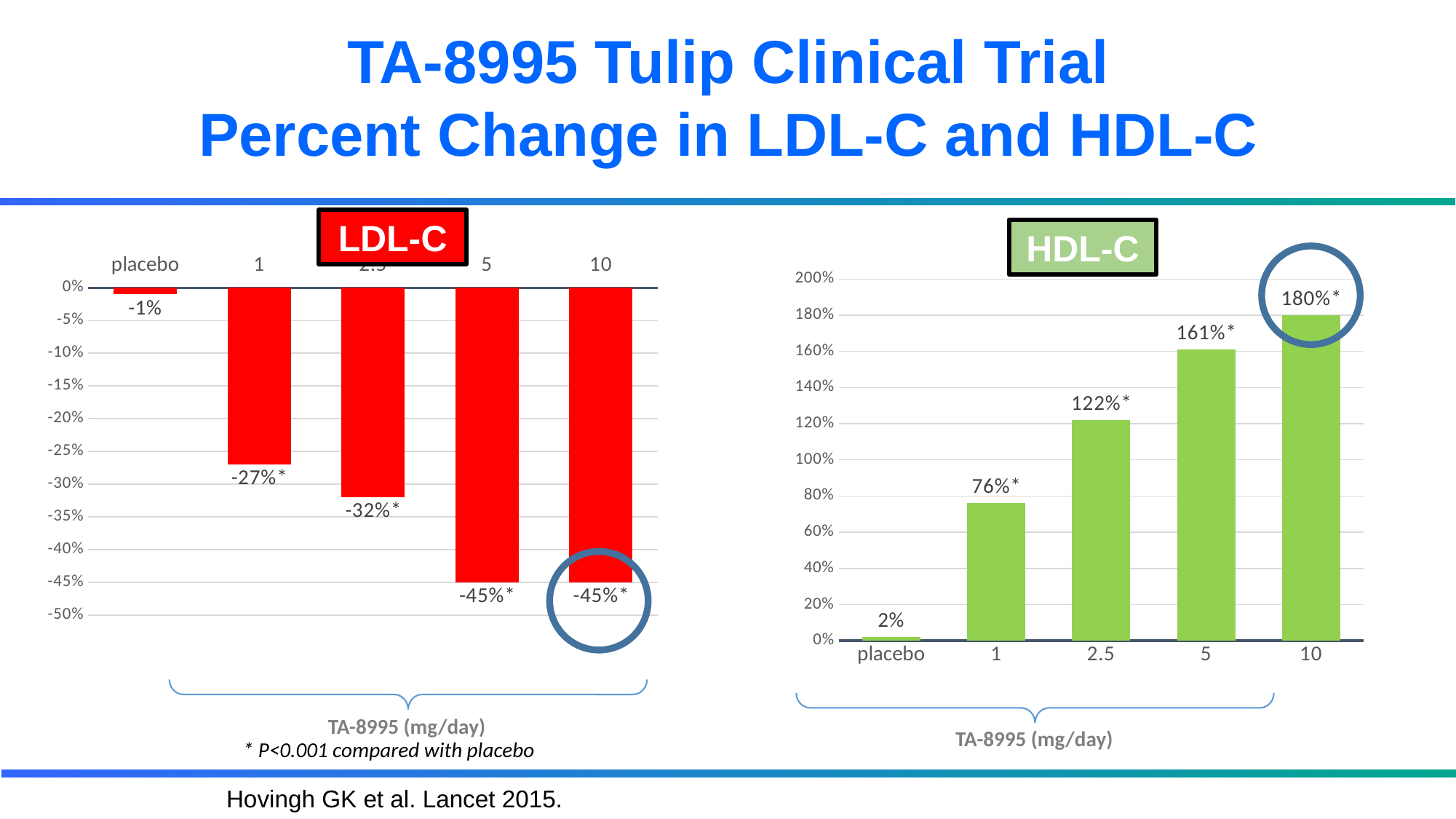
In the HDL-C chart, do the values rise or fall as the dose increases from placebo to 10 mg/day? rise In the LDL-C chart, what is the percent change for placebo? -1% In the HDL-C chart, what is the percent change for the 10 mg/day dose? 180% In the HDL-C chart, what is the difference between the percent change at 5 mg/day and at 2.5 mg/day? 39% In the HDL-C chart, which category has the lowest percent change? placebo In the HDL-C chart, which dose has the highest percent change? 10 In the LDL-C chart, what is the difference between the percent change at 1 mg/day and at 5 mg/day? 18% How many categories are shown on the x axis of the HDL-C chart? 5 What type of chart is the HDL-C chart? bar chart In the LDL-C chart, what is the percent change for the 1 mg/day dose? -27% In the HDL-C chart, what is the percent change for placebo? 2% In the HDL-C chart, is the percent change at 1 mg/day larger or smaller than at 2.5 mg/day? smaller